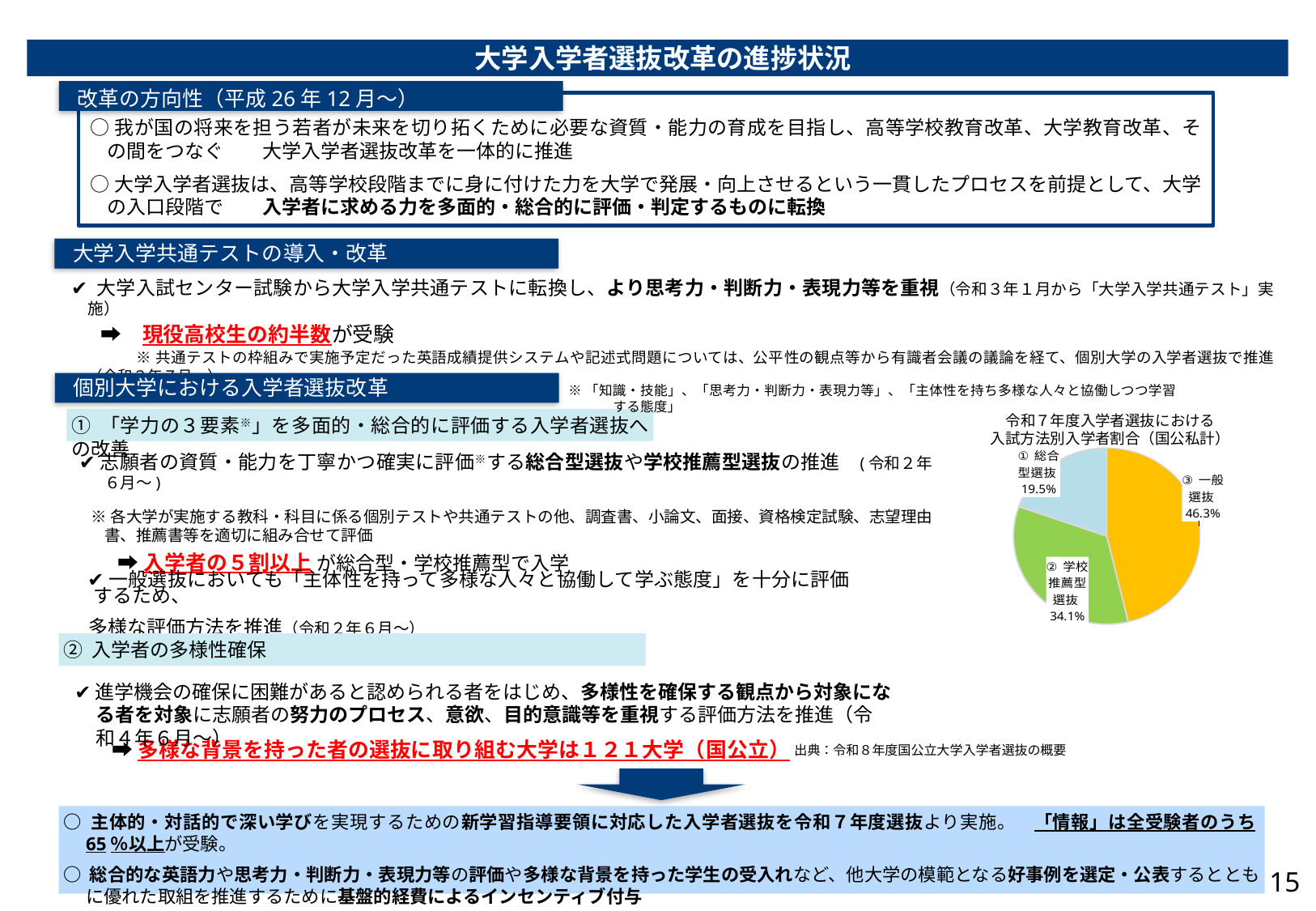
Which selection method has the largest share in the pie chart? ③ 一般選抜 What is the difference in percentage points between ② 学校推薦型選抜 and ① 総合型選抜? 14.6 What colour is the ③ 一般選抜 slice in the pie chart? yellow How many slices does the pie chart have? 3 What type of chart is shown on the slide? pie chart Which is larger in the pie chart, ② 学校推薦型選抜 or ① 総合型選抜? ② 学校推薦型選抜 Which selection method has the smallest share in the pie chart? ① 総合型選抜 What is the difference in percentage points between ③ 一般選抜 and ② 学校推薦型選抜? 12.2 What share of the pie does ② 学校推薦型選抜 represent? 34.1% What is the title of the pie chart? 令和7年度入学者選抜における入試方法別入学者割合（国公私計） What share of the pie does ① 総合型選抜 represent? 19.5% What share of the pie does ③ 一般選抜 represent? 46.3%